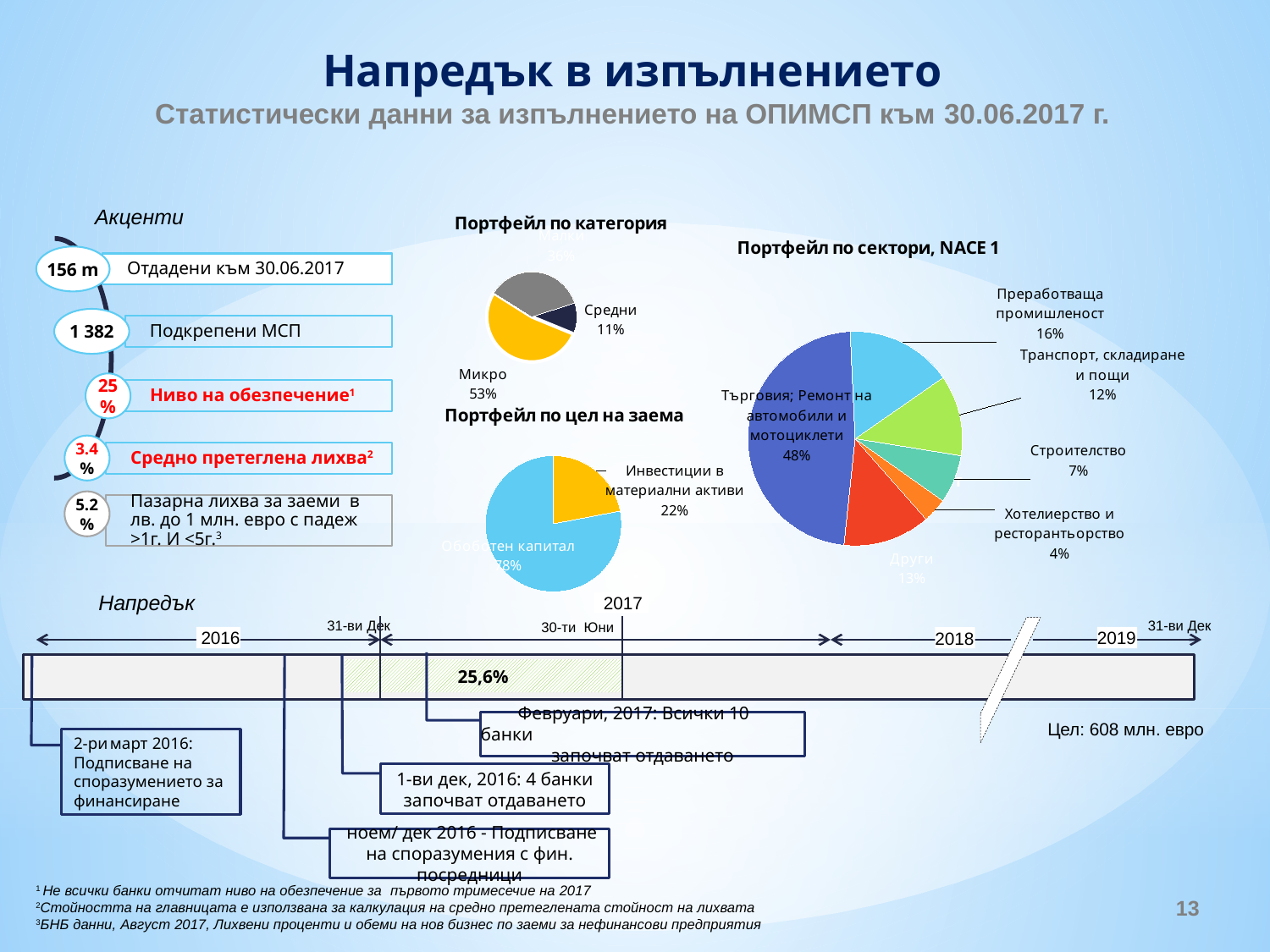
In the 'Портфейл по сектори, NACE 1' chart, what is the difference between the shares of Транспорт, складиране и пощи and Хотелиерство и ресторантьорство? 8% In the 'Портфейл по цел на заема' chart, what share is labelled for Инвестиции в материални активи? 22% In the 'Портфейл по категория' chart, what share is labelled for Микро? 53% In the 'Портфейл по категория' chart, which is larger, Микро or Средни? Микро What kind of chart is 'Портфейл по цел на заема'? Pie chart In the 'Портфейл по сектори, NACE 1' chart, which labelled sector has the largest share? Търговия; Ремонт на автомобили и мотоциклети In the 'Портфейл по категория' chart, what is the difference between the Микро and Средни shares? 42% How many pie charts are shown on the slide? 3 In the 'Портфейл по сектори, NACE 1' chart, what share is labelled for Търговия; Ремонт на автомобили и мотоциклети? 48% In the 'Портфейл по сектори, NACE 1' chart, what share is labelled for Преработваща промишленост? 16% In the 'Портфейл по сектори, NACE 1' chart, what share is labelled for Строителство? 7% In the 'Портфейл по категория' chart, what share is labelled for Средни? 11%